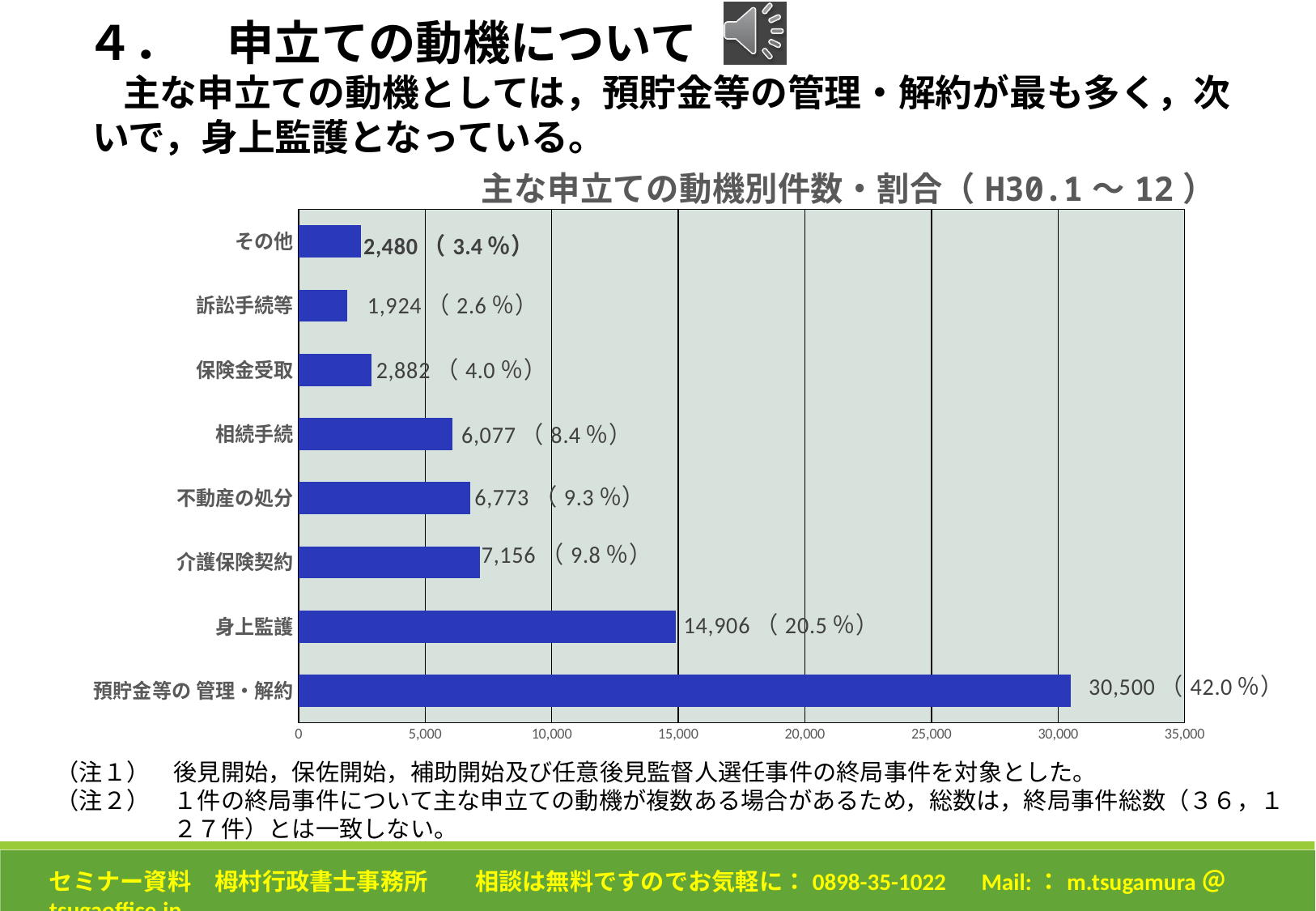
Is the value for 身上監護 greater or less than 15,000? less What is the number of cases for 訴訟手続等? 1,924 What is the difference in cases between 介護保険契約 and 不動産の処分? 383 What is the number of cases for 身上監護? 14,906 Which category has the highest number of cases? 預貯金等の管理・解約 What is the title of the chart? 主な申立ての動機別件数・割合（H30.1～12） Which category has the lowest number of cases? 訴訟手続等 How many categories are shown in the chart? 8 What percentage is shown for 不動産の処分? 9.3％ What kind of chart is shown on the slide? Bar chart Which has more cases, 相続手続 or 保険金受取? 相続手続 What is the difference in cases between 預貯金等の管理・解約 and 身上監護? 15,594